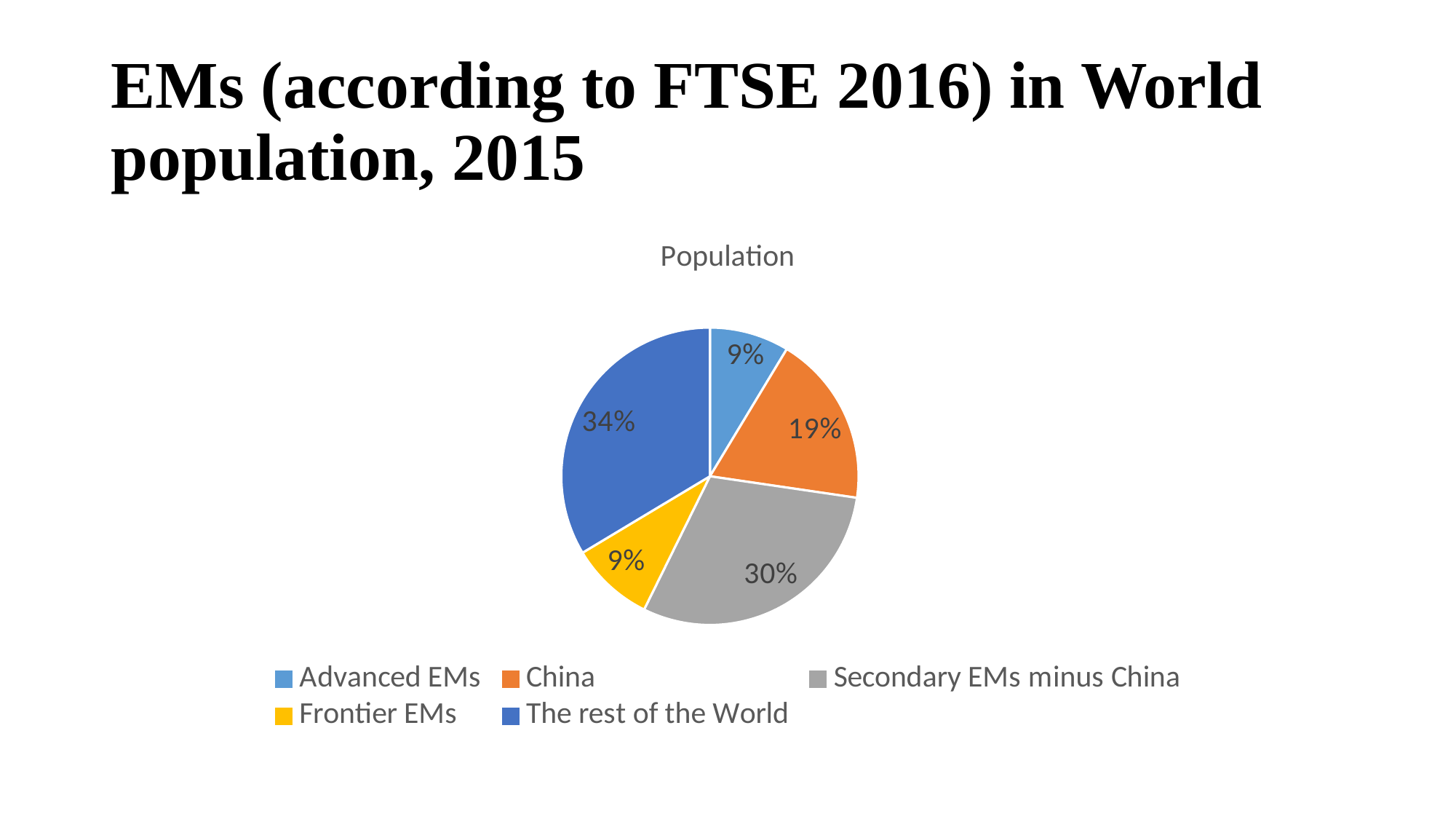
Which category has the largest slice of the pie? The rest of the World Which is larger, the share for China or the share for Secondary EMs minus China? Secondary EMs minus China What kind of chart is shown on the slide? pie chart How many slices does the pie chart have? 5 What is the difference in percentage points between The rest of the World and China? 15 What share of world population do Advanced EMs account for? 9% What share of world population do Secondary EMs minus China account for? 30% What is the title of the chart? Population What is the combined share of Advanced EMs and Frontier EMs? 18% Which colour represents Frontier EMs in the legend? yellow What share of world population does The rest of the World account for? 34% What share of world population does China account for? 19%